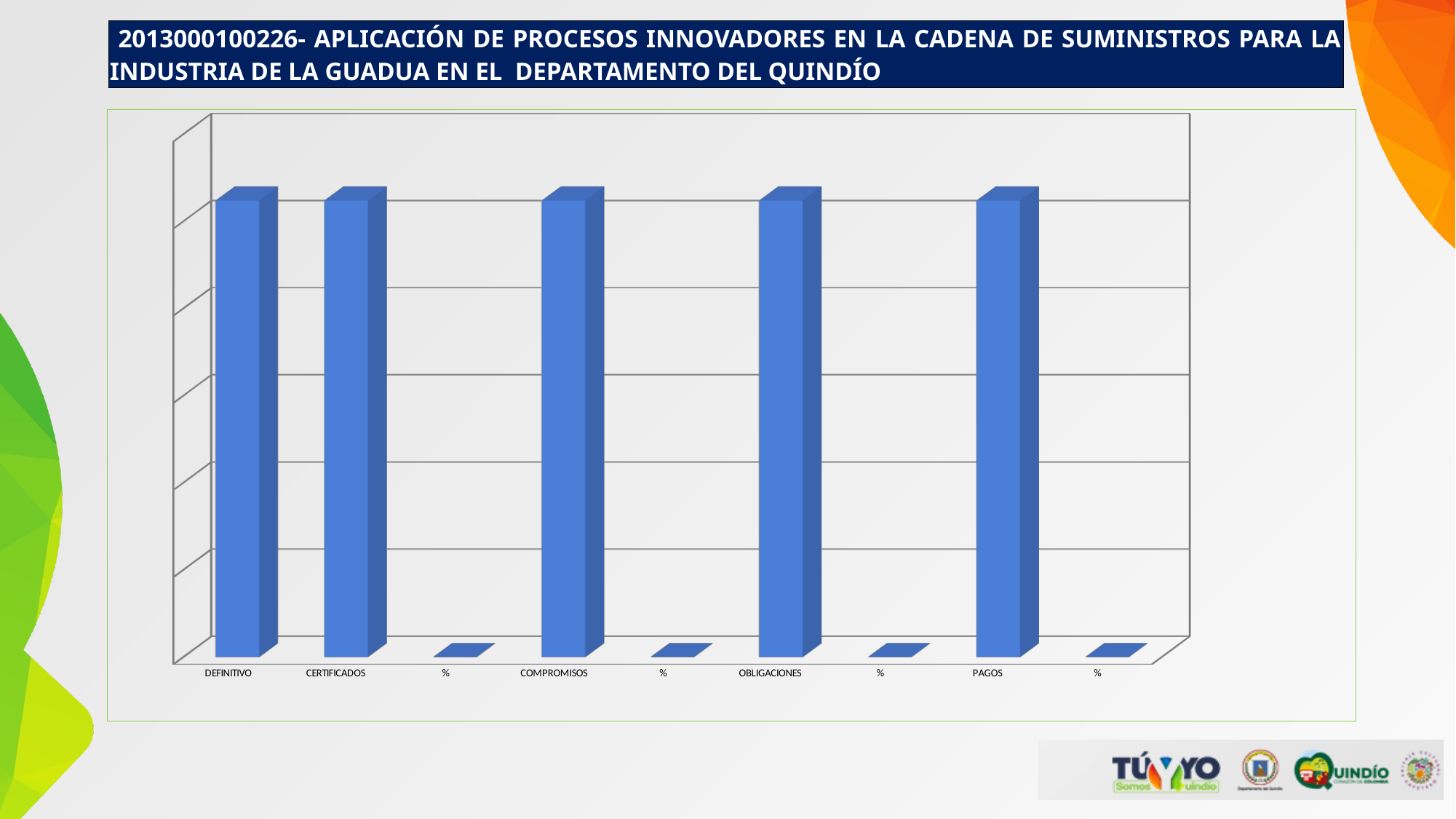
What kind of chart is shown on the slide? bar chart How many bars (categories) are plotted on the chart? 9 What colour are the bars in the chart? blue Which is larger, the bar for OBLIGACIONES or the % bar immediately to its left? OBLIGACIONES Which is larger, the bar for PAGOS or the % bar immediately to its right? PAGOS Which is larger, the bar for COMPROMISOS or the % bar immediately to its right? COMPROMISOS How many of the bars are labelled "%" on the x axis? 4 What is the label of the first category on the x axis? DEFINITIVO